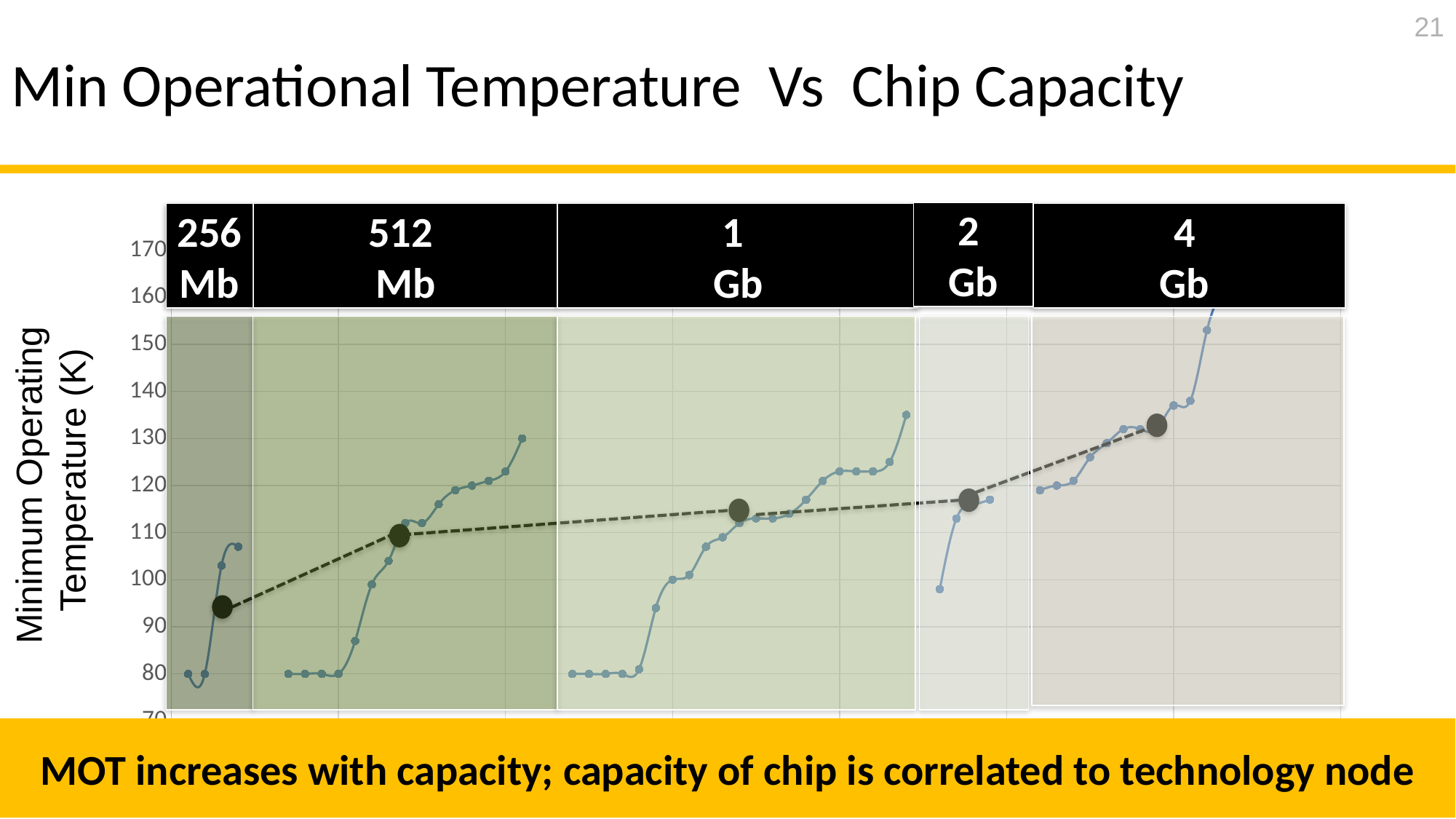
Is the large marker for the 4 Gb group greater or less than 120? greater What is the title of the slide containing the chart? Min Operational Temperature Vs Chip Capacity Which chip capacity group has the lowest large dashed-line marker? 256 Mb Is the large marker for the 1 Gb group greater or less than 110? greater How many chip capacity groups are labelled across the top of the chart? 5 What kind of chart is shown on the slide? line chart Is the large marker for the 256 Mb group greater or less than 100? less Which chip capacity group has the highest minimum operating temperatures? 4 Gb Does the dashed trend line rise or fall as chip capacity increases from 256 Mb to 4 Gb? rises What is the label of the y axis? Minimum Operating Temperature (K) Which is larger, the large marker for the 4 Gb group or the large marker for the 256 Mb group? 4 Gb